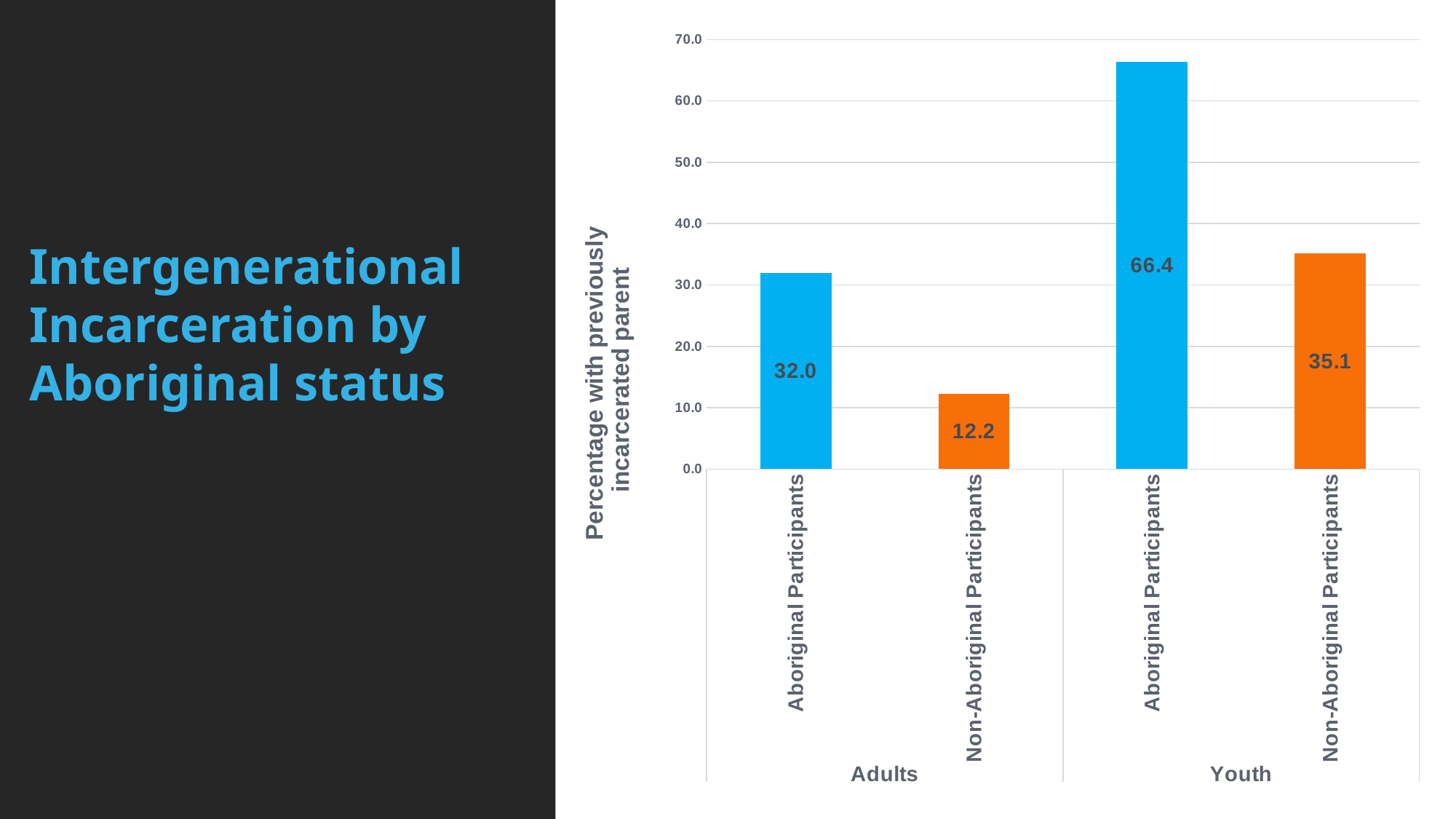
What is the value for Non-Aboriginal Participants in the Youth group? 35.1 What is the label of the vertical axis? Percentage with previously incarcerated parent Which is larger: Aboriginal Participants in the Adults group or Non-Aboriginal Participants in the Youth group? Non-Aboriginal Participants in the Youth group What is the value for Aboriginal Participants in the Adults group? 32.0 What kind of chart is shown on the slide? bar chart How many bars are plotted on the chart? 4 Is the value for Non-Aboriginal Participants in the Adults group greater or less than 20.0? less What is the value for Aboriginal Participants in the Youth group? 66.4 Which bar has the lowest value? Non-Aboriginal Participants (Adults) Which bar has the highest value? Aboriginal Participants (Youth) What is the difference between Aboriginal Participants and Non-Aboriginal Participants in the Adults group? 19.8 What is the difference between Aboriginal Participants and Non-Aboriginal Participants in the Youth group? 31.3